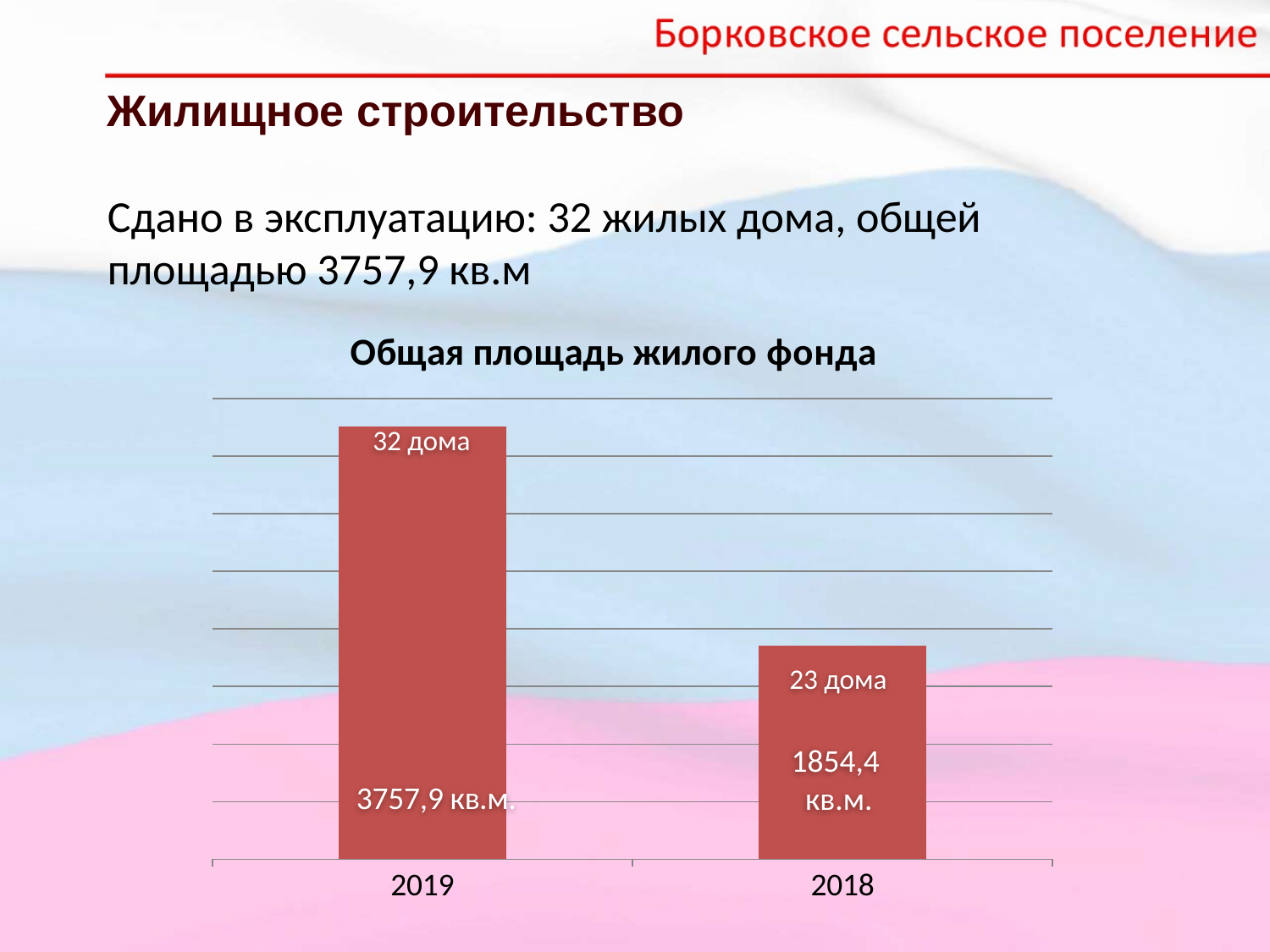
Which year has the lowest bar? 2018 What is the title of the chart? Общая площадь жилого фонда How many houses are labelled on the 2018 bar? 23 дома How many more houses were built in 2019 than in 2018? 9 What is the difference in floor area between 2019 and 2018? 1903,5 кв.м. What is the total floor area shown for 2018? 1854,4 кв.м. Which year has the highest bar? 2019 How many houses are labelled on the 2019 bar? 32 дома What is the total floor area shown for 2019? 3757,9 кв.м. What kind of chart is shown on the slide? bar chart Which is larger, the value for 2019 or the value for 2018? 2019 How many bars are shown in the chart? 2